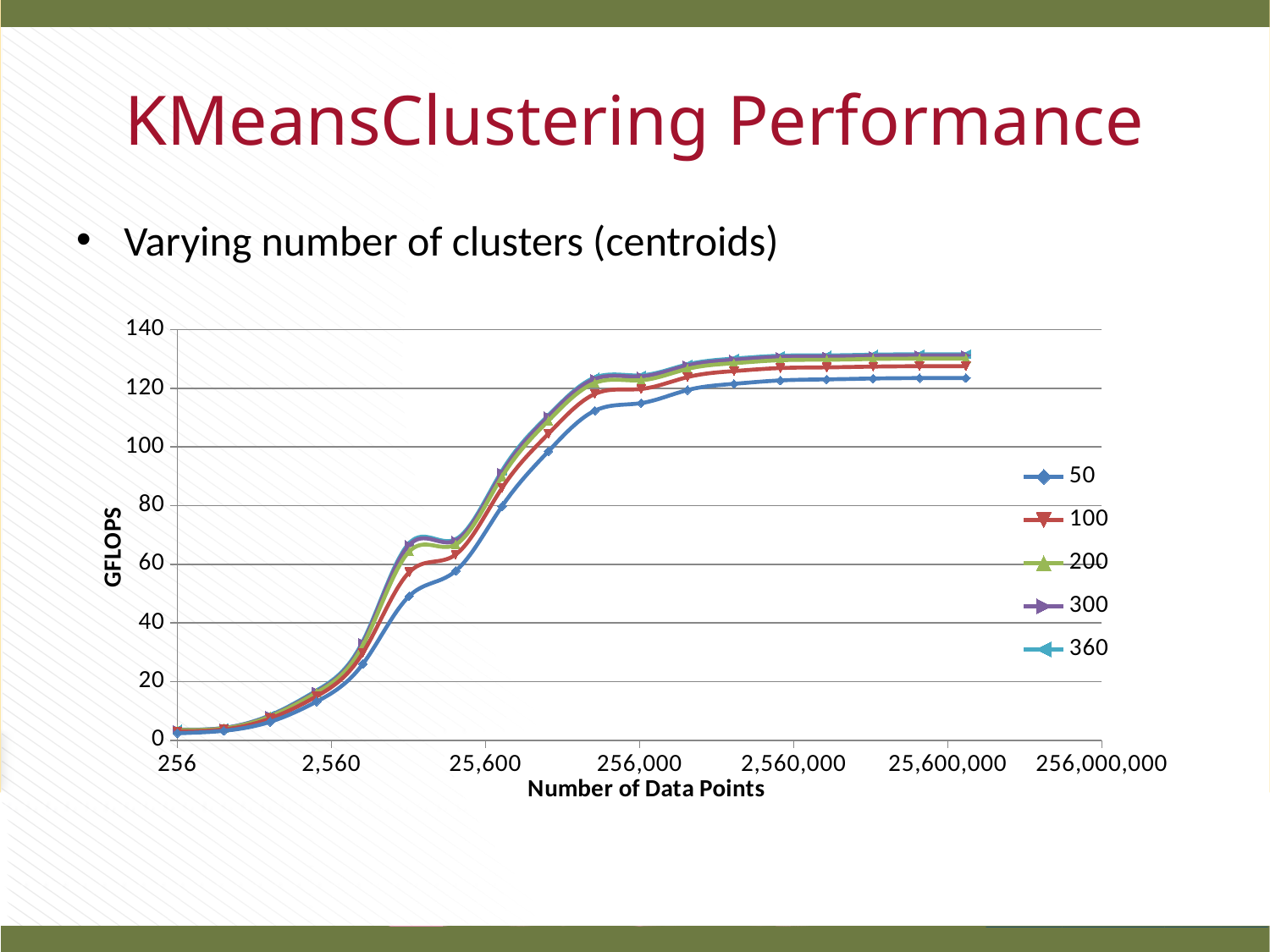
At the largest number of data points plotted, which series has the lowest GFLOPS? 50 At 25,600 data points, which is higher, the 50 series or the 300 series? 300 At 25,600 data points, is the value for the 50 series greater or less than 40? greater What kind of chart is shown on the slide? line chart At the largest number of data points plotted, is the value for the 50 series greater or less than 140? less At 256 data points, is the value for the 50 series greater or less than 20? less What are the series names listed in the legend? 50, 100, 200, 300, 360 How many series does the legend list? 5 At the largest number of data points plotted, which is higher, the 50 series or the 360 series? 360 Do the GFLOPS values rise or fall as the number of data points increases along the x axis? rise What is the title of the y axis? GFLOPS